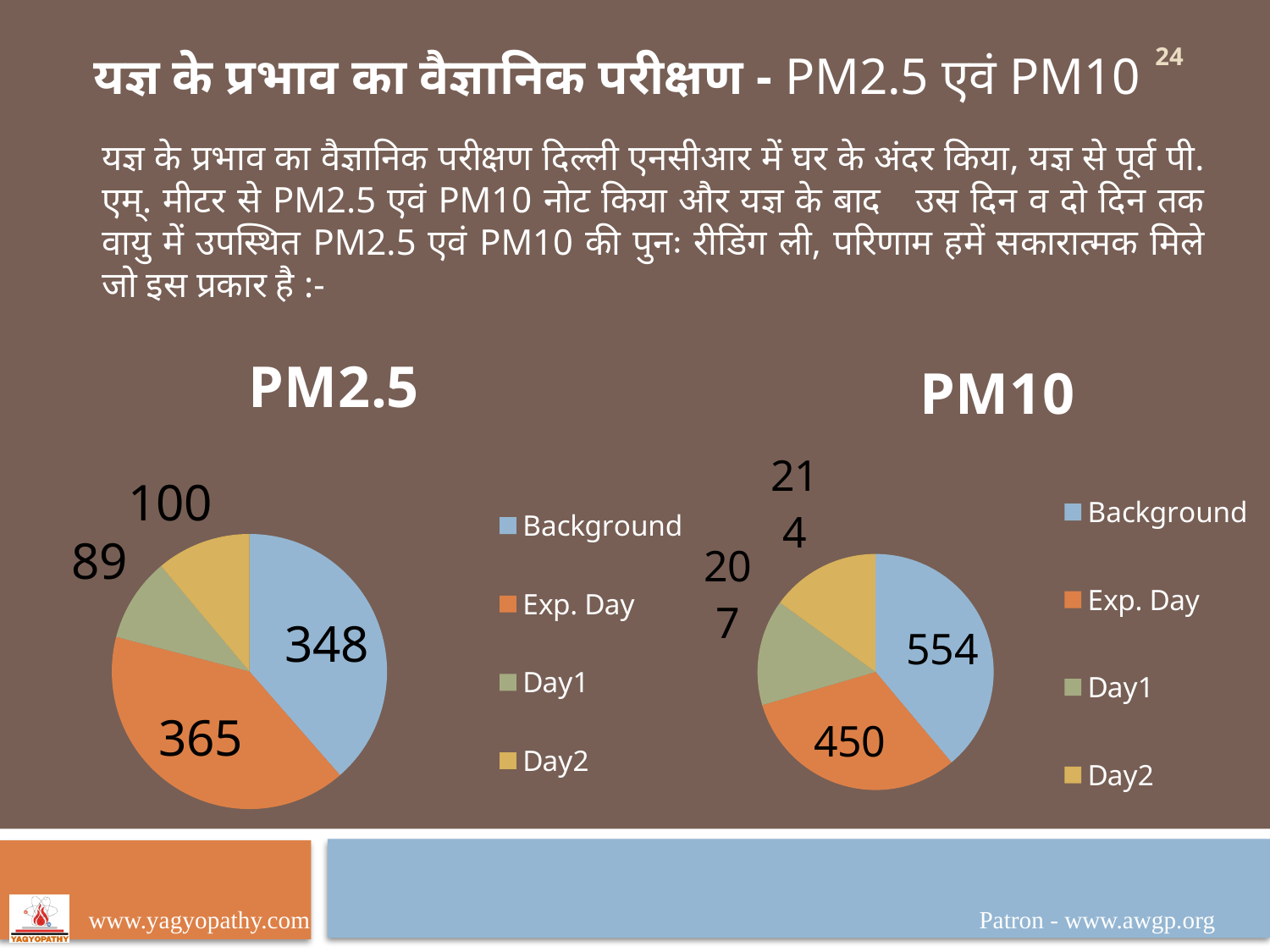
In the PM10 pie chart, what is the difference between the Background value and the Exp. Day value? 104 What kind of chart is the PM2.5 chart? Pie chart In the PM2.5 pie chart, which category has the largest value? Exp. Day In the PM2.5 pie chart, what is the value for Background? 348 In the PM10 pie chart, what is the value for Background? 554 How many categories does the legend of the PM10 chart list? 4 In the PM2.5 pie chart, which category has the smallest value? Day1 In the PM10 pie chart, which category has the largest value? Background In the PM10 pie chart, what is the value for Exp. Day? 450 In the PM2.5 pie chart, what is the value for Day2? 100 In the PM2.5 pie chart, what is the value for Exp. Day? 365 In the PM2.5 pie chart, what is the value for Day1? 89